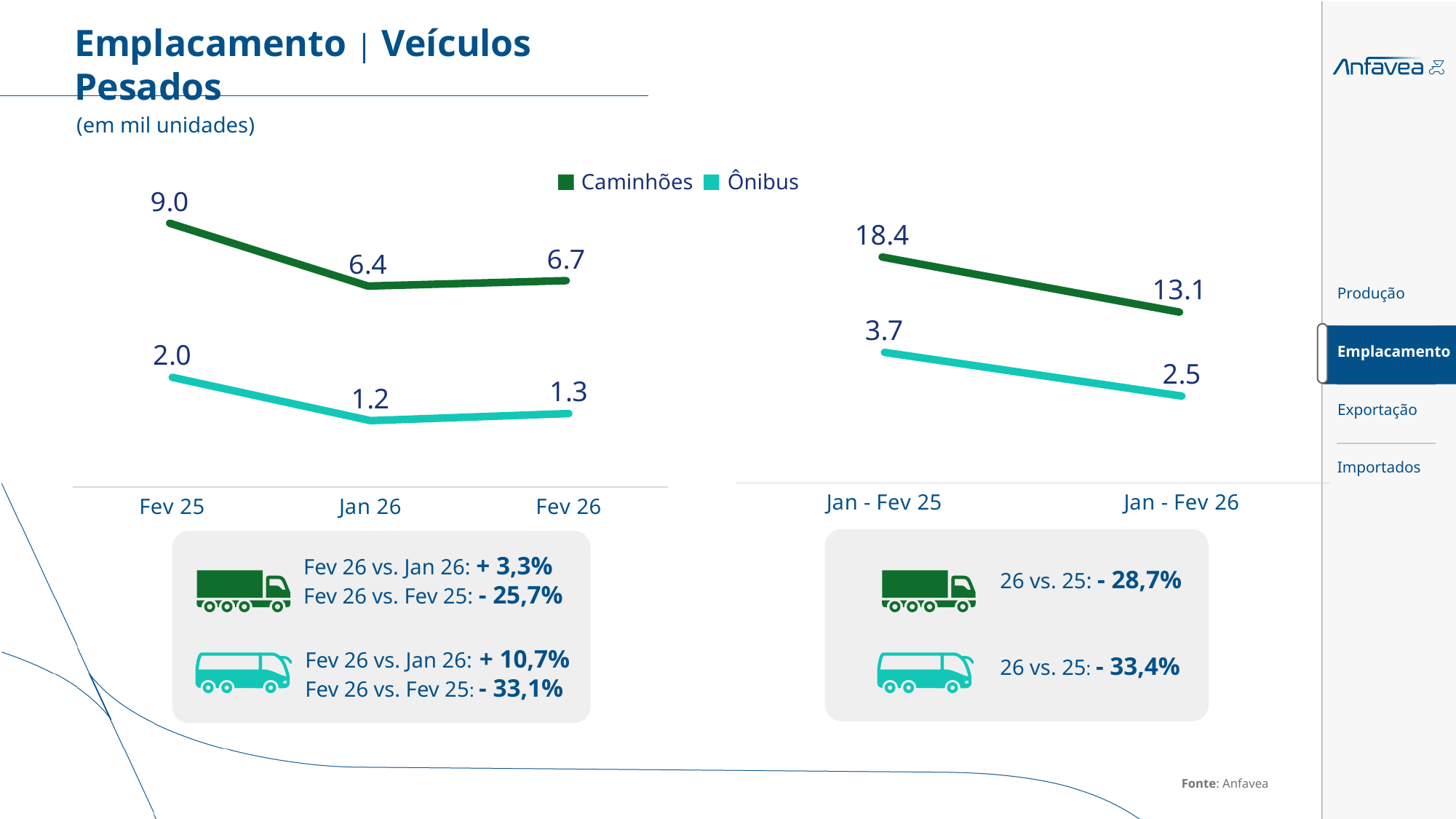
In the left chart (monthly), which is larger: the Ônibus value for Fev 25 or for Fev 26? Fev 25 In the left chart (monthly), which period has the lowest value for Ônibus? Jan 26 In the left chart (monthly), what is the value for Caminhões in Fev 26? 6.7 In the right chart (cumulative), what is the value for Caminhões in Jan - Fev 26? 13.1 How many periods are shown on the x axis of the left chart (monthly)? 3 In the right chart (cumulative), do the Ônibus values rise or fall from Jan - Fev 25 to Jan - Fev 26? fall In the left chart (monthly), which period has the highest value for Caminhões? Fev 25 How many series does the legend list? 2 In the left chart (monthly), what is the value for Ônibus in Jan 26? 1.2 In the right chart (cumulative), what is the value for Ônibus in Jan - Fev 25? 3.7 In the right chart (cumulative), what is the difference between the Caminhões values for Jan - Fev 25 and Jan - Fev 26? 5.3 In the left chart (monthly), what is the difference between the Caminhões values for Fev 25 and Jan 26? 2.6